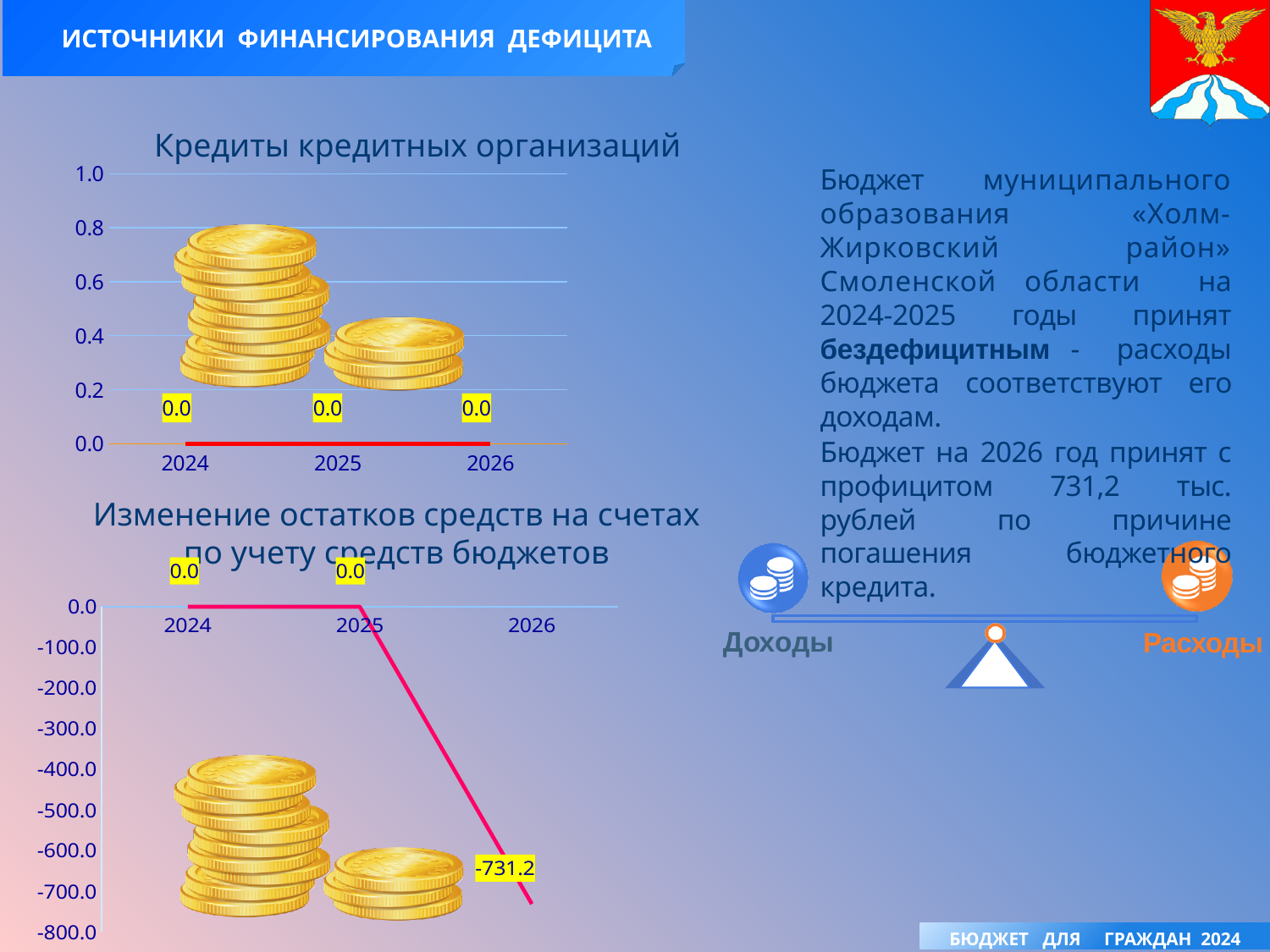
What type of chart is 'Кредиты кредитных организаций'? line chart On the chart 'Изменение остатков средств на счетах по учету средств бюджетов', what is the value for 2026? -731.2 On the chart 'Изменение остатков средств на счетах по учету средств бюджетов', what is the value for 2025? 0.0 On the chart 'Кредиты кредитных организаций', what is the value for 2024? 0.0 On the chart 'Изменение остатков средств на счетах по учету средств бюджетов', which year has the lowest value? 2026 How many years are plotted on the chart 'Кредиты кредитных организаций'? 3 On the chart 'Изменение остатков средств на счетах по учету средств бюджетов', is the value for 2026 greater or less than -700.0? less On the chart 'Изменение остатков средств на счетах по учету средств бюджетов', which is larger, the value for 2024 or the value for 2026? 2024 On the chart 'Кредиты кредитных организаций', what is the value for 2026? 0.0 On the chart 'Изменение остатков средств на счетах по учету средств бюджетов', do the values rise or fall from 2025 to 2026? fall On the chart 'Изменение остатков средств на счетах по учету средств бюджетов', what is the difference between the values for 2025 and 2026? 731.2 What type of chart is 'Изменение остатков средств на счетах по учету средств бюджетов'? line chart